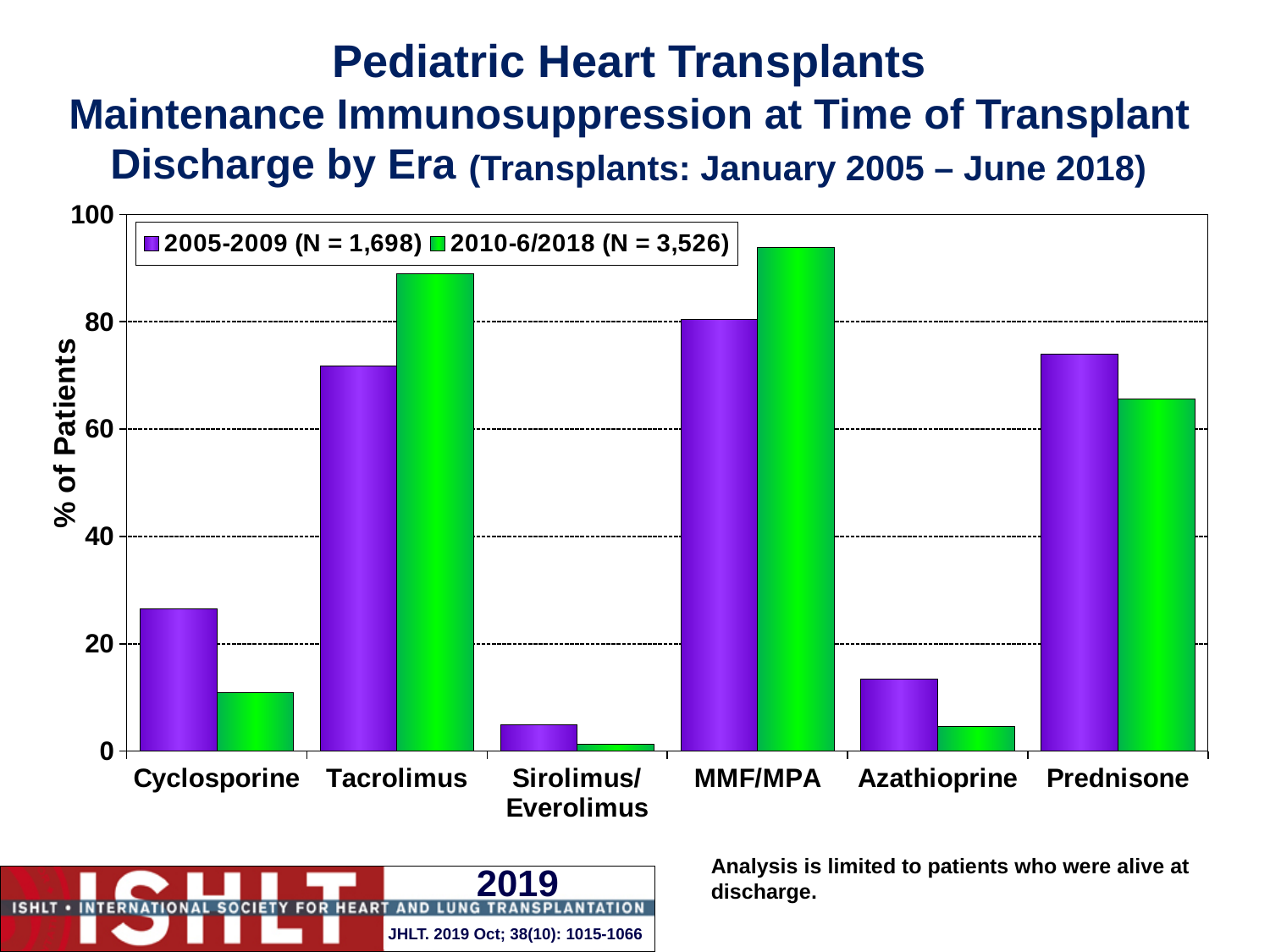
What is the N shown in the legend for the 2005-2009 series? 1,698 Which category has the highest value for the 2010-6/2018 series? MMF/MPA How many immunosuppression categories are shown on the x axis? 6 What kind of chart is shown on the slide? bar chart Which category has the highest value for the 2005-2009 series? MMF/MPA Is the 2010-6/2018 value for Tacrolimus greater or less than 80? greater Which category has the lowest value for the 2010-6/2018 series? Sirolimus/Everolimus For Tacrolimus, which era has the larger value, 2005-2009 or 2010-6/2018? 2010-6/2018 How many series does the legend list? 2 For Prednisone, which era has the larger value, 2005-2009 or 2010-6/2018? 2005-2009 Is the 2005-2009 value for Cyclosporine greater or less than 20? greater Is the 2010-6/2018 value for Azathioprine greater or less than 20? less